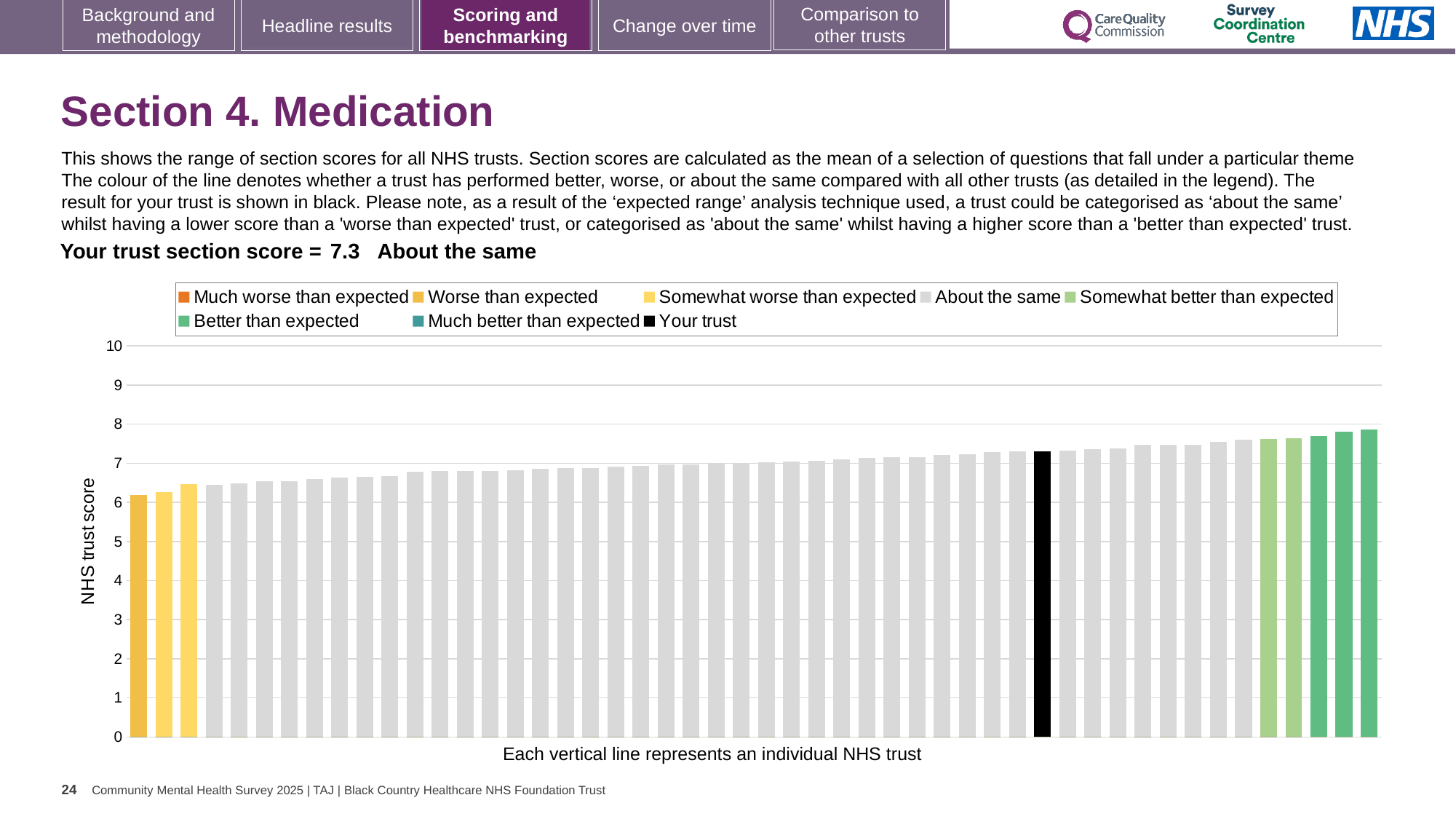
How many entries does the chart legend list? 8 Do the bar values rise or fall from left to right along the x axis? rise What kind of chart is shown on the slide? bar chart Is the value of the lowest bar greater or less than 7? less Is the value of the highest bar greater or less than 7? greater What colour is the bar representing your trust? black Is the value of the highest bar greater or less than 8? less Which category is your trust's section score placed in? About the same What is the label on the y axis of the chart? NHS trust score Which is larger: the value of your trust's bar or the value of the leftmost bar? your trust's bar What is the section score for your trust shown on the slide? 7.3